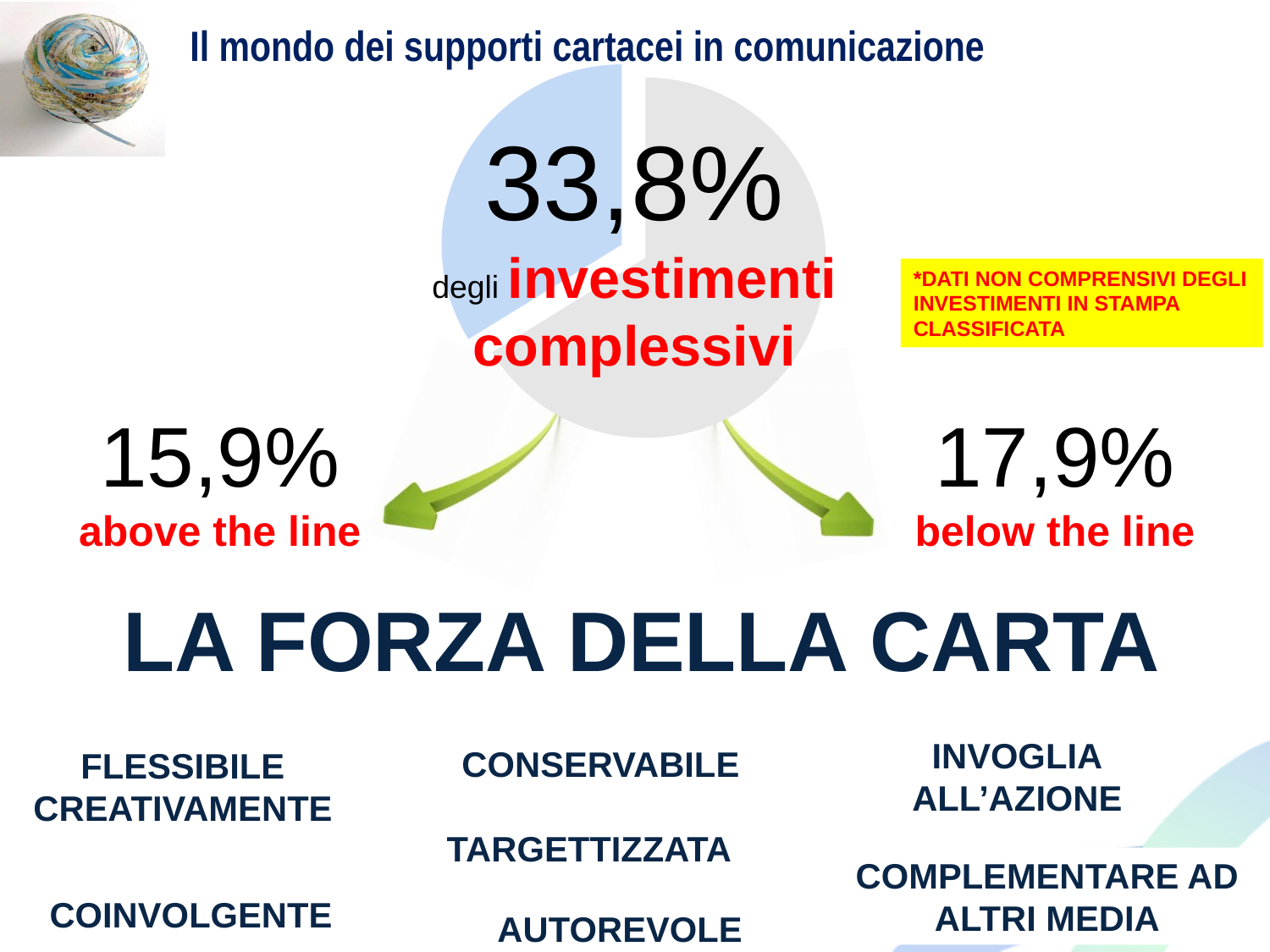
According to the note on the slide, what do the data not include? investimenti in stampa classificata What is the value shown for 'above the line'? 15,9% What is the value shown for 'below the line'? 17,9% What colour is the slice representing 33,8% of total investments? blue What kind of chart is shown on the slide? pie chart What is the difference between the 'below the line' value and the 'above the line' value? 2,0% Is the blue slice of the pie greater or less than half of the pie? less What share of total investments (investimenti complessivi) does the highlighted blue slice of the pie represent? 33,8% What is the sum of the 'above the line' and 'below the line' values? 33,8% How many slices does the pie chart have? 2 Which is larger, the 'above the line' value or the 'below the line' value? below the line